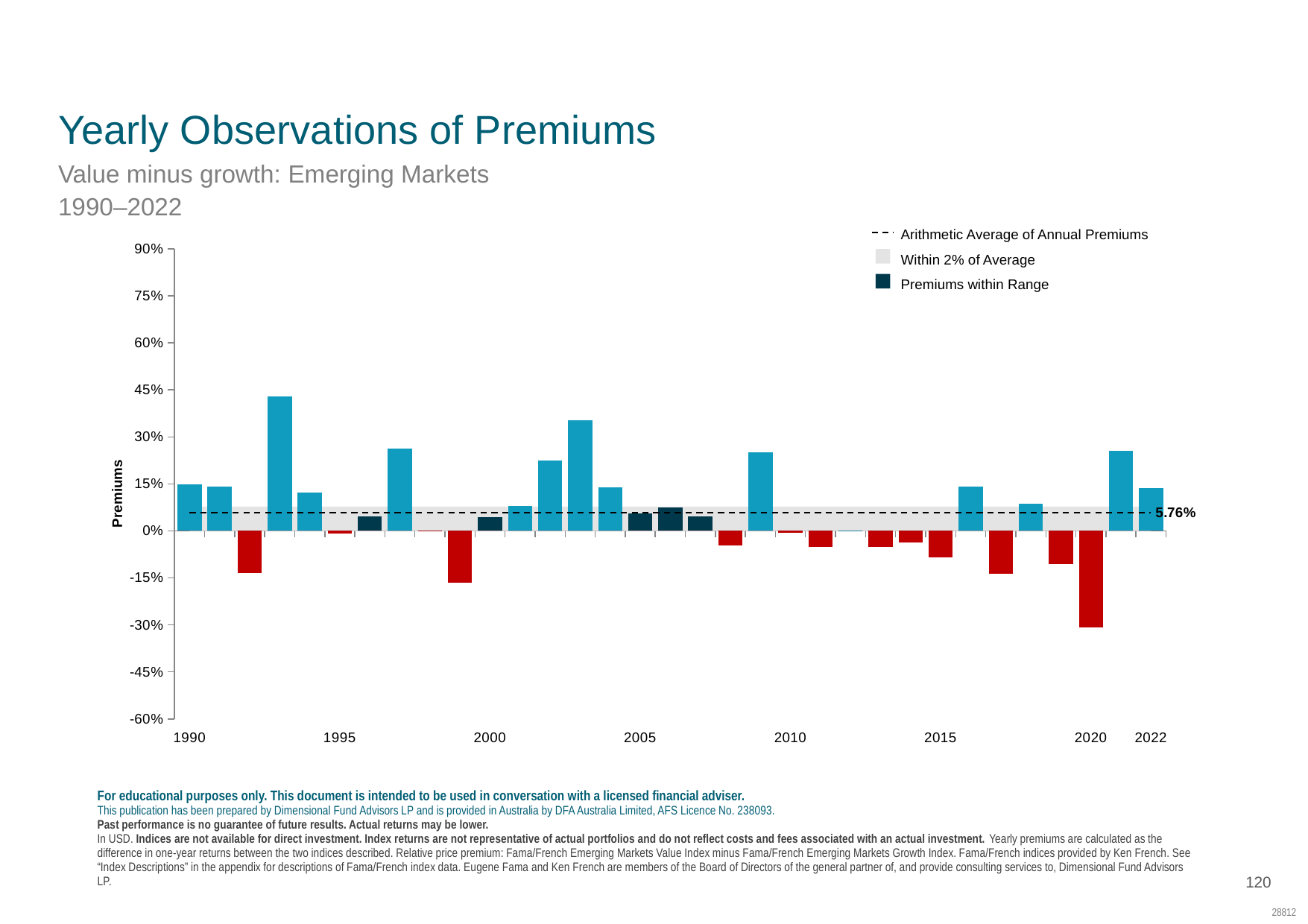
Which year has the larger premium, 1993 or 2003? 1993 How many years are plotted on the chart? 33 Is the premium for 2017 greater or less than 0%? less How many entries does the legend list? 3 Is the premium for 2009 greater or less than 15%? greater Is the premium for 2020 greater or less than -15%? less Which year has the lowest premium on the chart? 2020 Which year has the highest premium on the chart? 1993 What does the dashed horizontal line on the chart represent, according to the legend? Arithmetic Average of Annual Premiums What is the arithmetic average of annual premiums shown on the chart? 5.76% What kind of chart is shown on the slide? bar chart